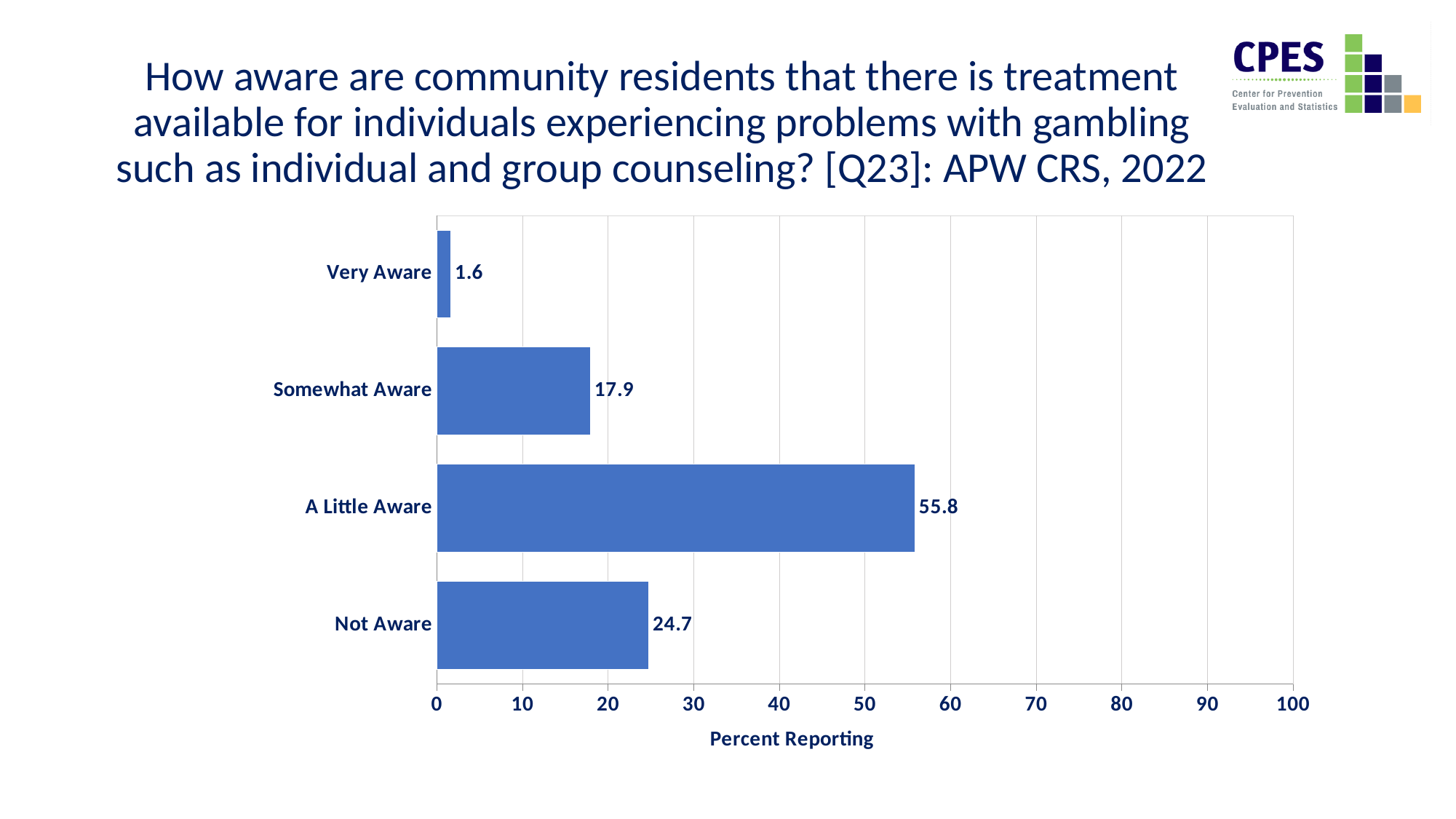
Which has a larger percent reporting, 'Not Aware' or 'Somewhat Aware'? Not Aware What is the difference in percent reporting between 'Somewhat Aware' and 'Very Aware'? 16.3 What is the label of the horizontal axis? Percent Reporting How many awareness categories are shown in the chart? 4 Which awareness category has the highest percent reporting? A Little Aware What percent of residents reported being 'Very Aware'? 1.6 What kind of chart is shown on the slide? Bar chart What percent of residents reported being 'A Little Aware'? 55.8 What percent of residents reported being 'Somewhat Aware'? 17.9 Which awareness category has the lowest percent reporting? Very Aware What percent of residents reported being 'Not Aware'? 24.7 What is the difference in percent reporting between 'A Little Aware' and 'Not Aware'? 31.1